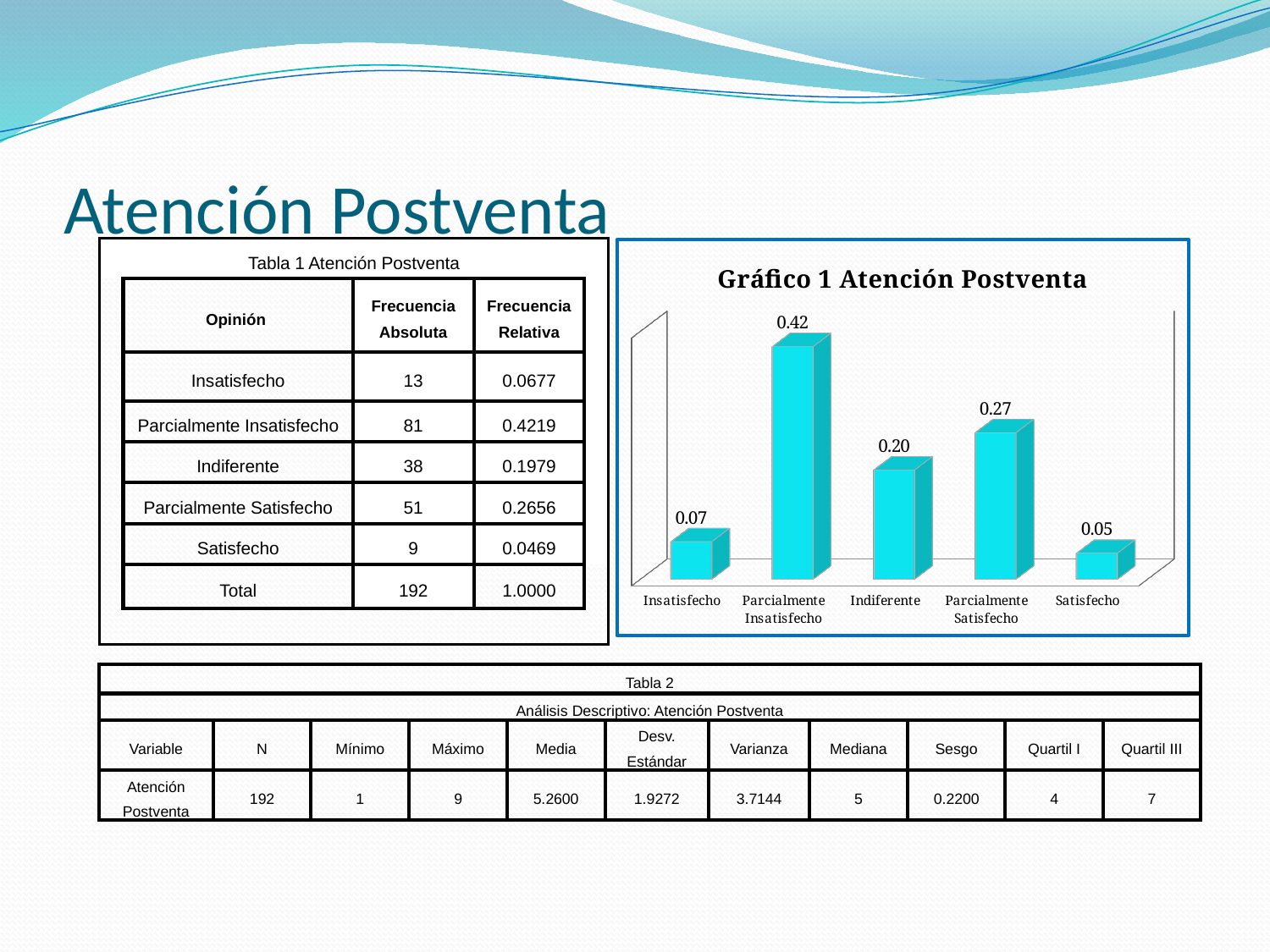
What is the value for Insatisfecho in the chart? 0.07 How many categories are shown in the chart? 5 What kind of chart is shown on the slide? Bar chart What is the difference between the values for Parcialmente Insatisfecho and Parcialmente Satisfecho? 0.15 Which is larger, the value for Indiferente or the value for Insatisfecho? Indiferente What is the value for Satisfecho in the chart? 0.05 Which category has the lowest value in the chart? Satisfecho What is the title of the chart? Gráfico 1 Atención Postventa Which category has the highest value in the chart? Parcialmente Insatisfecho What is the value for Parcialmente Insatisfecho in the chart? 0.42 What is the value for Indiferente in the chart? 0.20 What is the difference between the values for Indiferente and Satisfecho? 0.15